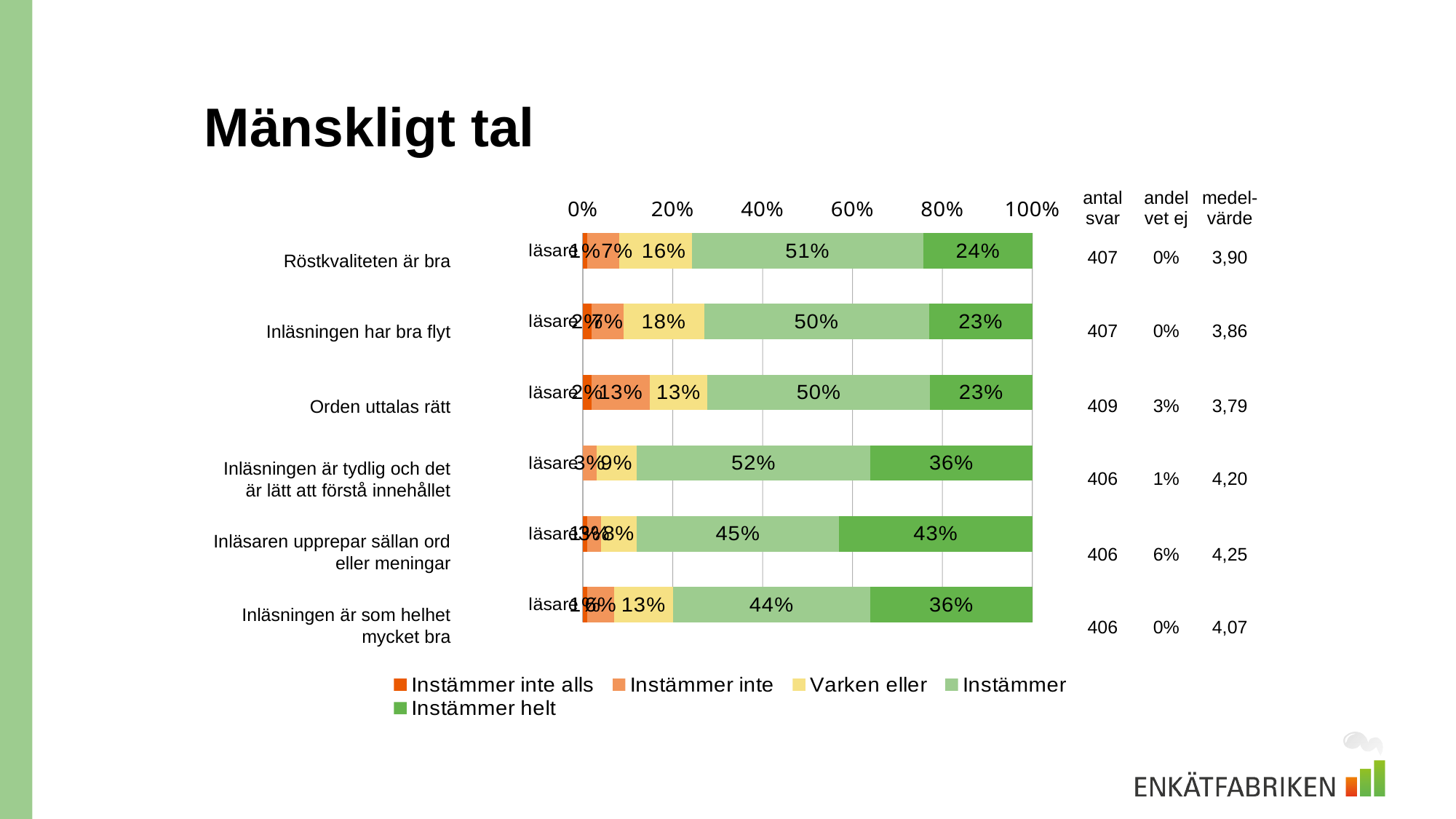
What is the "Varken eller" share for "Inläsningen har bra flyt"? 18% Which statement has the lowest "Instämmer" share? Inläsningen är som helhet mycket bra Which has a larger "Instämmer helt" share: "Röstkvaliteten är bra" or "Inläsningen är tydlig och det är lätt att förstå innehållet"? Inläsningen är tydlig och det är lätt att förstå innehållet How many series does the legend list? 5 What is the "Instämmer helt" share for "Inläsningen är som helhet mycket bra"? 36% What kind of chart is shown on the slide? Stacked bar chart How many statements (bars) are shown in the chart? 6 What percentage of respondents answered "Instämmer helt" for "Inläsaren upprepar sällan ord eller meningar"? 43% What is the title of the slide? Mänskligt tal What percentage of respondents answered "Instämmer" for "Röstkvaliteten är bra"? 51% How many percentage points higher is the "Instämmer helt" share for "Inläsaren upprepar sällan ord eller meningar" than for "Inläsningen är som helhet mycket bra"? 7 percentage points Which statement has the highest "Instämmer helt" share? Inläsaren upprepar sällan ord eller meningar